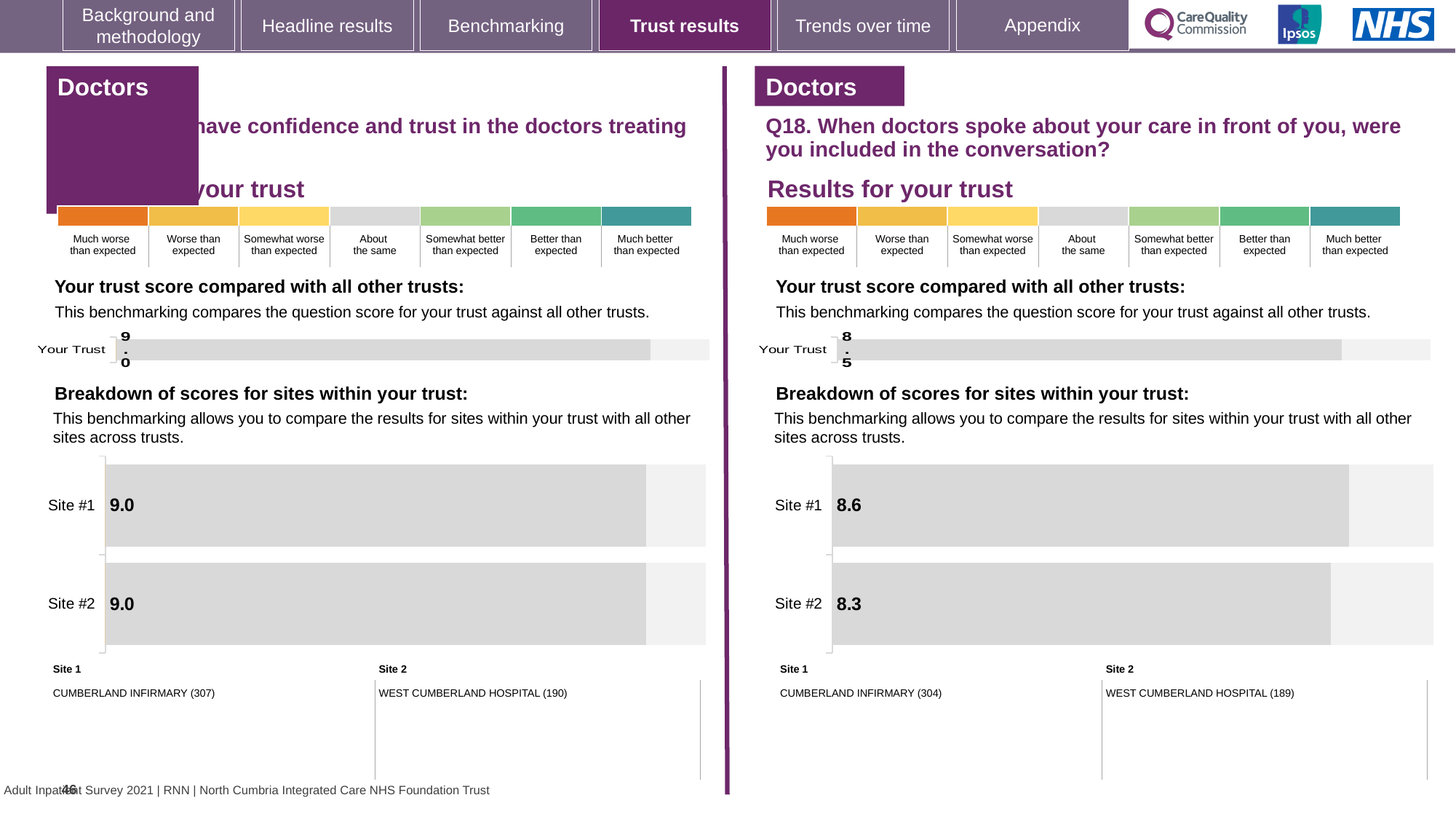
On the right-hand slide (Q18), in the breakdown of scores for sites chart, what is the score for Site #2? 8.3 On the left-hand slide, in the breakdown of scores for sites chart, what is the score for Site #2? 9.0 On the left-hand slide, what is the score shown for Your Trust in the trust score comparison chart? 9.0 On the right-hand slide (Q18), in the breakdown of scores for sites chart, what is the score for Site #1? 8.6 On the right-hand slide (Q18), which site has the higher score in the breakdown of scores for sites chart? Site #1 What type of chart is used for the breakdown of scores for sites on the right-hand slide (Q18)? Bar chart On the left-hand slide, in the breakdown of scores for sites chart, what is the score for Site #1? 9.0 On the right-hand slide (Q18), which site has the lower score in the breakdown of scores for sites chart? Site #2 Which is larger: the Your Trust score on the left-hand slide or the Your Trust score on the right-hand slide (Q18)? The left-hand slide (9.0) On the left-hand slide, how many sites are shown in the breakdown of scores for sites chart? 2 On the right-hand slide (Q18), what is the score shown for Your Trust in the trust score comparison chart? 8.5 On the right-hand slide (Q18), what is the difference between the Site #1 and Site #2 scores in the breakdown chart? 0.3